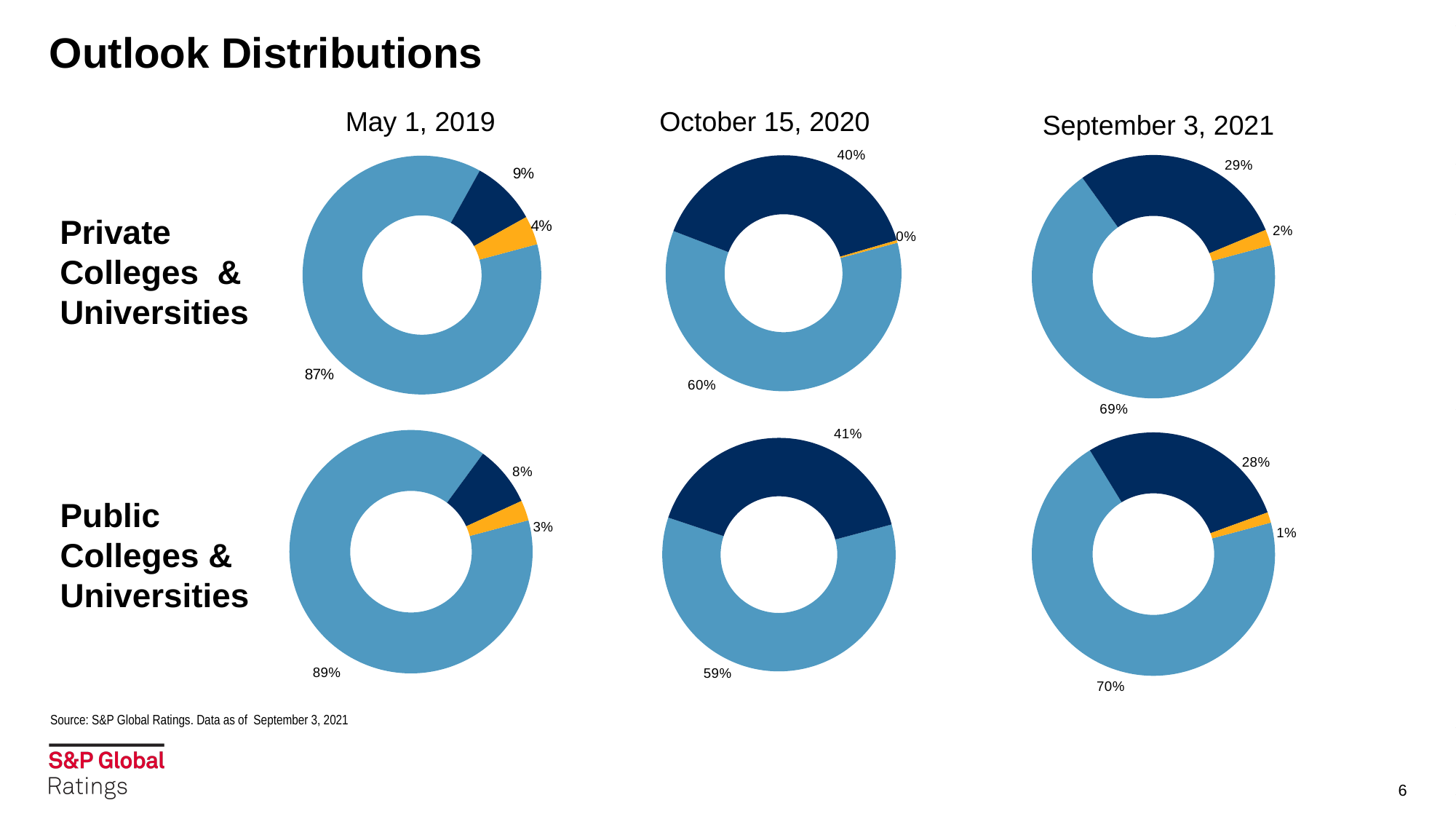
What are the three dates shown as column headings above the charts? May 1, 2019; October 15, 2020; September 3, 2021 In the Public Colleges & Universities chart for May 1, 2019, what share does the dark blue slice have? 8% In the Private Colleges & Universities chart for May 1, 2019, what share does the largest (light blue) slice have? 87% In the Public Colleges & Universities chart for September 3, 2021, what share does the orange slice have? 1% In the Private Colleges & Universities chart for September 3, 2021, what is the difference between the light blue slice and the dark blue slice? 40 percentage points In the Private Colleges & Universities chart for October 15, 2020, what share does the dark blue slice have? 40% How many donut charts are shown on the slide? 6 What kind of chart is used to show the outlook distributions on this slide? Donut (pie) chart Is the light blue slice larger in the Public Colleges & Universities chart for May 1, 2019 or in the Private Colleges & Universities chart for May 1, 2019? Public Colleges & Universities (89% vs 87%) Is the dark blue slice larger in the Private Colleges & Universities chart for October 15, 2020 or in the Private Colleges & Universities chart for September 3, 2021? October 15, 2020 (40% vs 29%) In the Private Colleges & Universities chart for September 3, 2021, which slice is the smallest? The orange slice (2%) In the Public Colleges & Universities chart for October 15, 2020, which slice is the largest? The light blue slice (59%)